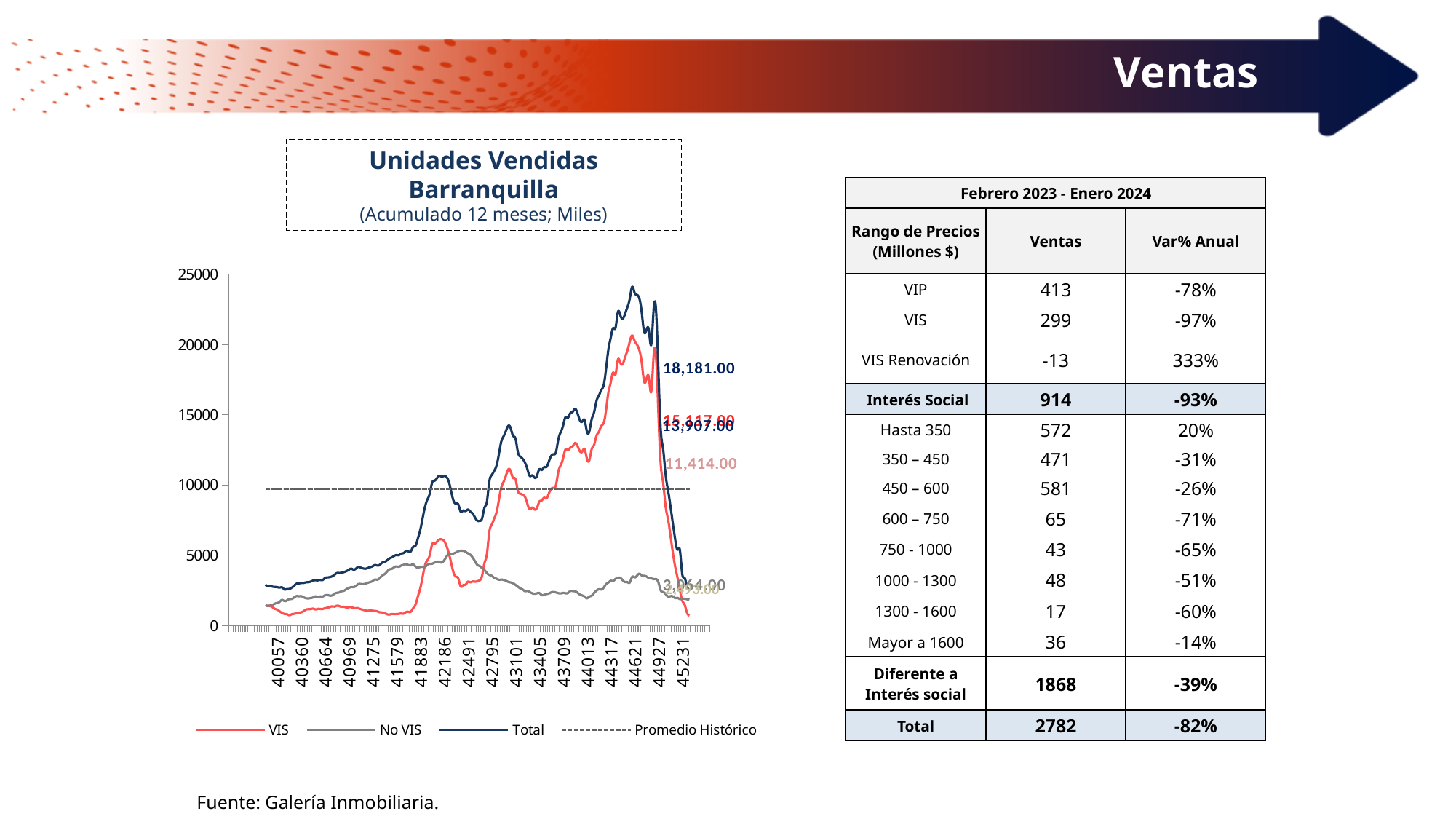
What is the highest value printed as a data label on the 'Unidades Vendidas Barranquilla' chart? 18,181.00 How many series does the legend of the 'Unidades Vendidas Barranquilla' chart list? 4 In the 'Unidades Vendidas Barranquilla' chart, is the peak value of the VIS line greater or less than 15000? greater In the 'Unidades Vendidas Barranquilla' chart, does the Total line rise or fall between 40057 and 44621? rise Which series in the 'Unidades Vendidas Barranquilla' chart is drawn as a dashed line? Promedio Histórico In the 'Unidades Vendidas Barranquilla' chart, does the Total line rise or fall after 44927? fall In the 'Unidades Vendidas Barranquilla' chart, is the peak value of the No VIS line greater or less than 10000? less In the 'Unidades Vendidas Barranquilla' chart, which series reaches the highest value? Total What colour is the 'Total' line in the 'Unidades Vendidas Barranquilla' chart? dark blue In the 'Unidades Vendidas Barranquilla' chart, is the Promedio Histórico line greater or less than 5000? greater What kind of chart is shown under the title 'Unidades Vendidas Barranquilla'? line chart